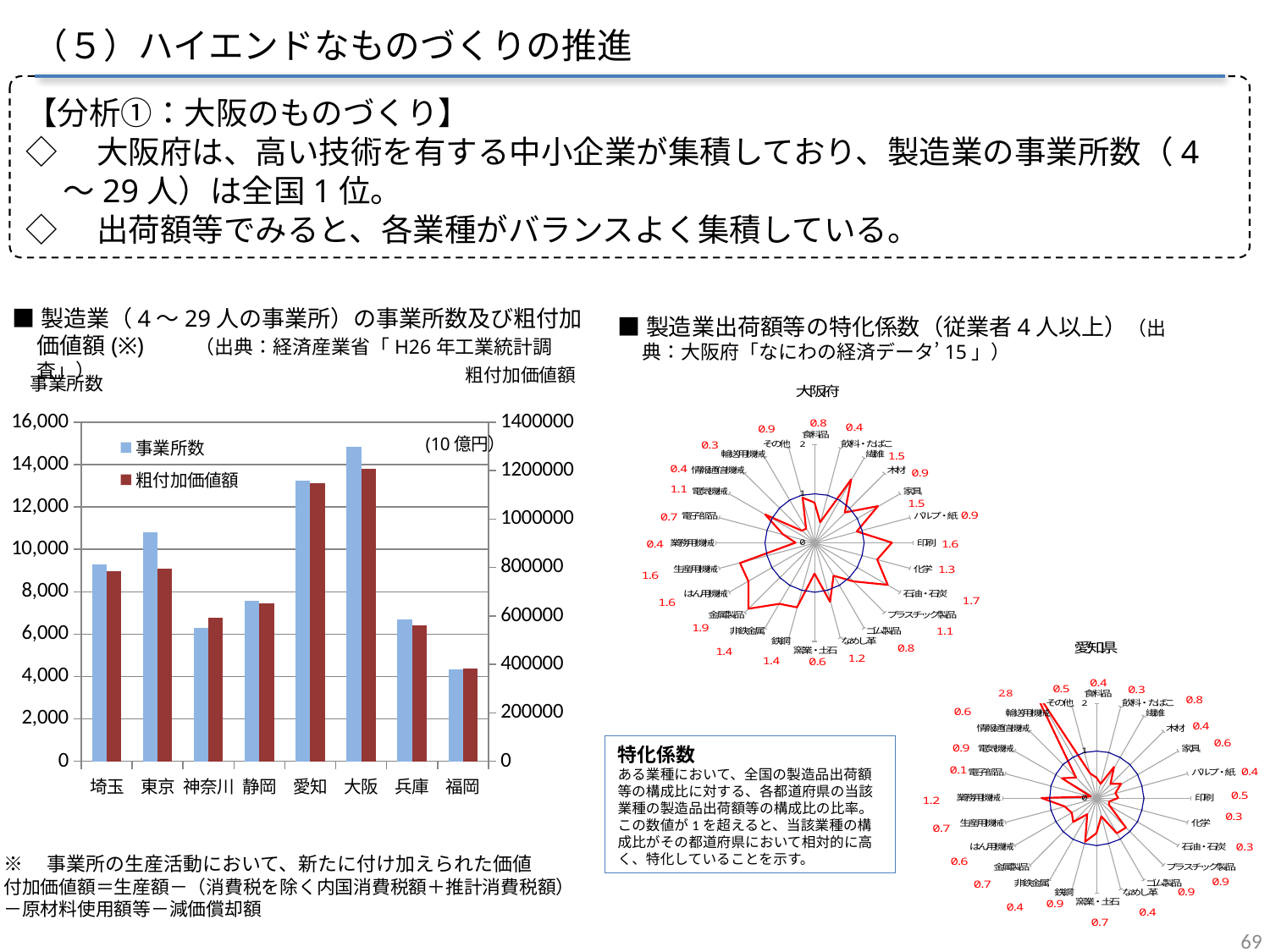
In the bar chart on the left, which prefecture has the lowest 事業所数? 福岡 In the 大阪府 radar chart, what is the 特化係数 for 金属製品? 1.9 In the 愛知県 radar chart, which industry has the highest 特化係数? 輸送用機械 In the bar chart on the left, how many series does the legend list? 2 In the 愛知県 radar chart, what is the difference between the 特化係数 for 輸送用機械 and 電子部品? 2.7 In the bar chart on the left, is the 事業所数 for 神奈川 greater or less than 8,000? less In the bar chart on the left, which has the larger 事業所数, 東京 or 埼玉? 東京 In the bar chart on the left (製造業の事業所数及び粗付加価値額), what kind of chart is it? bar chart In the bar chart on the left, is the 事業所数 for 大阪 greater or less than 14,000? greater In the bar chart on the left, how many prefectures are shown on the x axis? 8 In the bar chart on the left, which prefecture has the highest 事業所数? 大阪 In the 大阪府 radar chart, what is the 特化係数 for 石油・石炭? 1.7